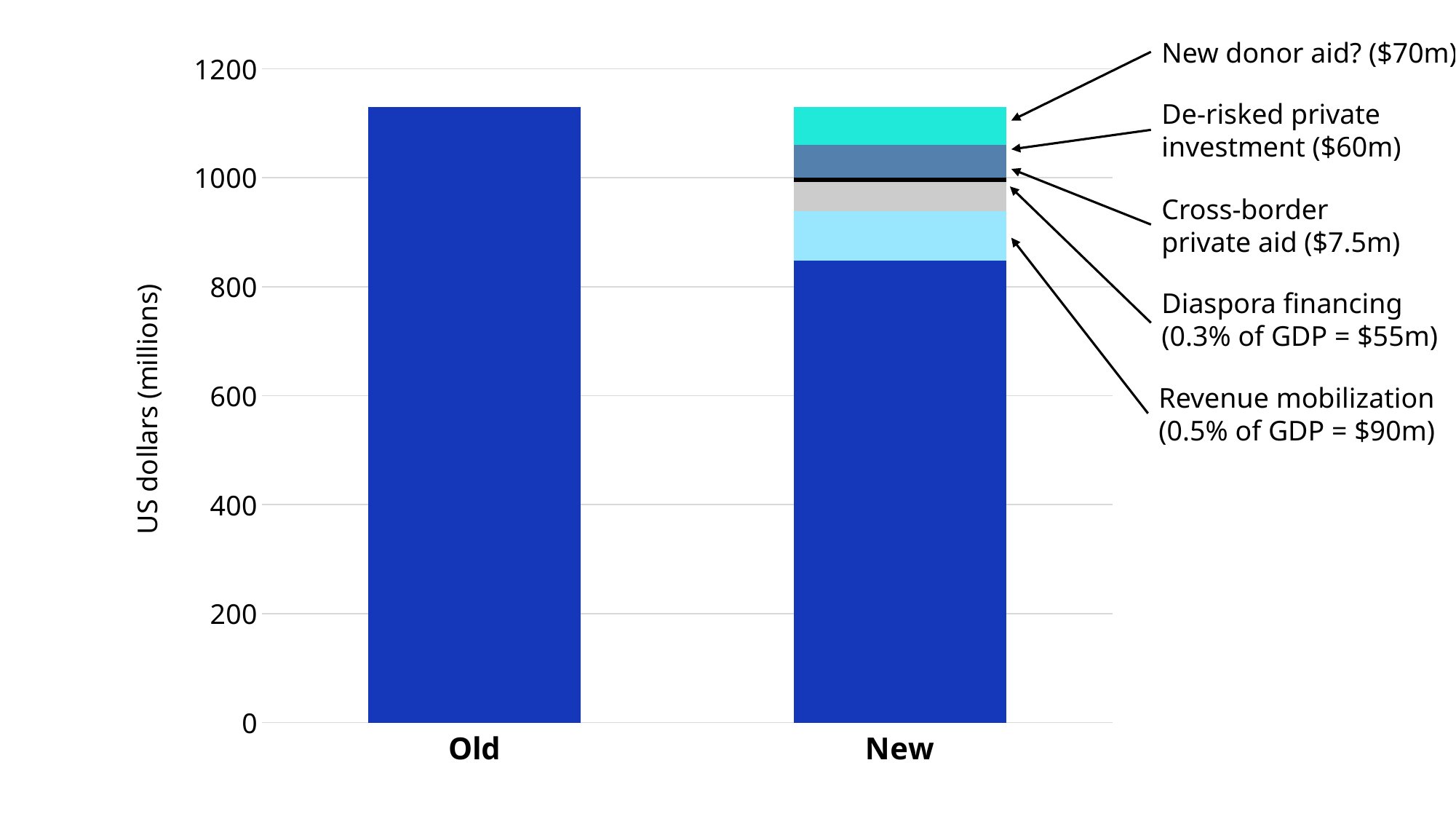
Which of the annotated financing sources in the New bar has the smallest value? Cross-border private aid What is the label on the y axis? US dollars (millions) What is the difference between the New donor aid value and the De-risked private investment value? $10m What kind of chart is shown on the slide? Stacked bar chart What is the value given for New donor aid in the New bar? $70m Which is larger, Diaspora financing or Revenue mobilization? Revenue mobilization How many categories are shown on the x axis? 2 Which of the annotated financing sources in the New bar has the largest value? Revenue mobilization What is the value given for De-risked private investment? $60m What is the value given for Cross-border private aid? $7.5m Is the value of the Old bar greater or less than 1000? greater What is the value given for Revenue mobilization? $90m